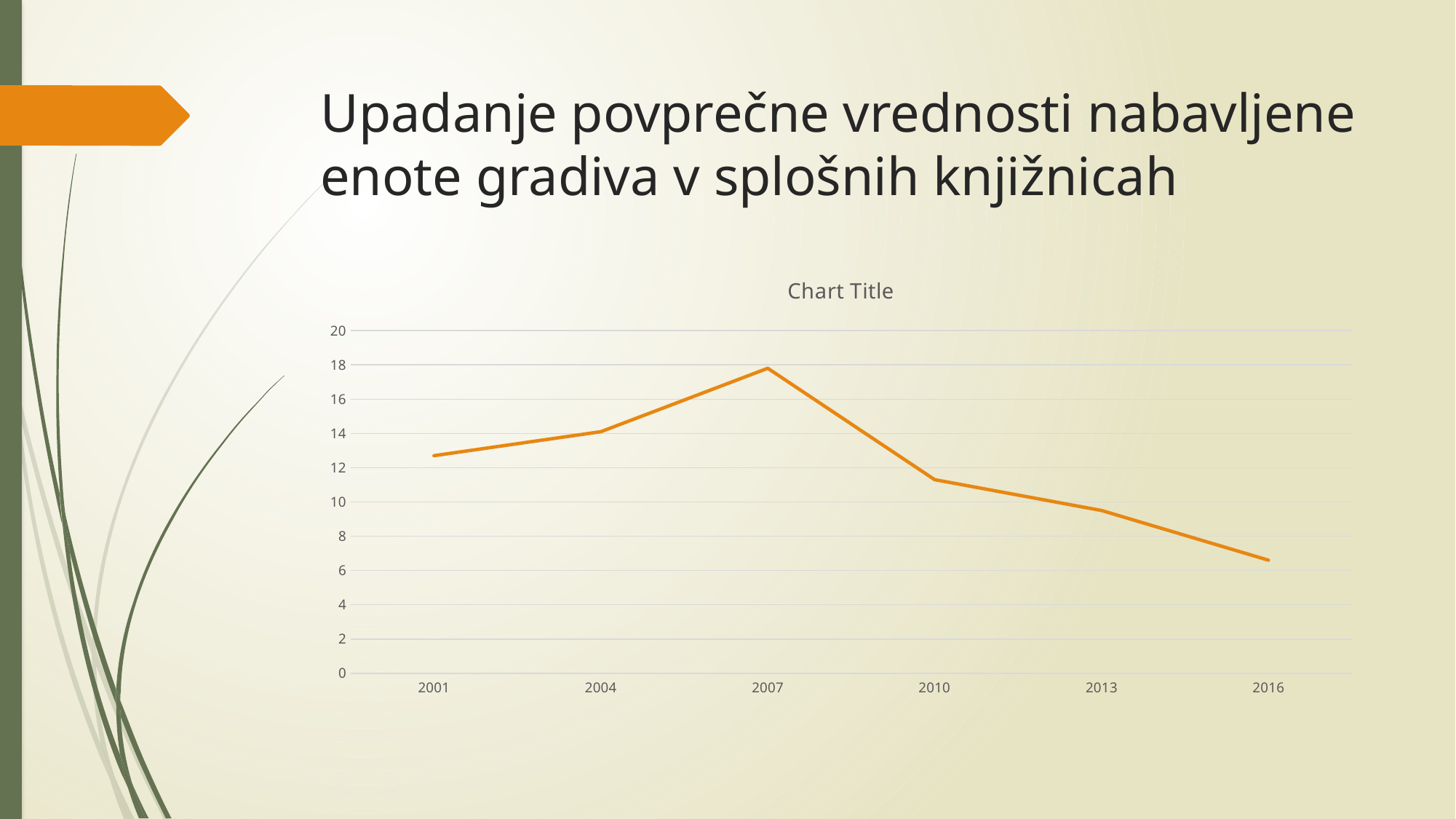
Is the value for 2016 greater or less than 8? less Which year has the larger value, 2004 or 2010? 2004 Which year has the larger value, 2013 or 2016? 2013 How many years are plotted along the x axis? 6 In which year is the plotted value lowest? 2016 What is the title printed above the chart? Chart Title Is the value for 2007 greater or less than 16? greater Is the value for 2001 greater or less than 12? greater In which year is the plotted value highest? 2007 What kind of chart is shown on the slide? line chart Do the values rise or fall from 2007 to 2016? fall